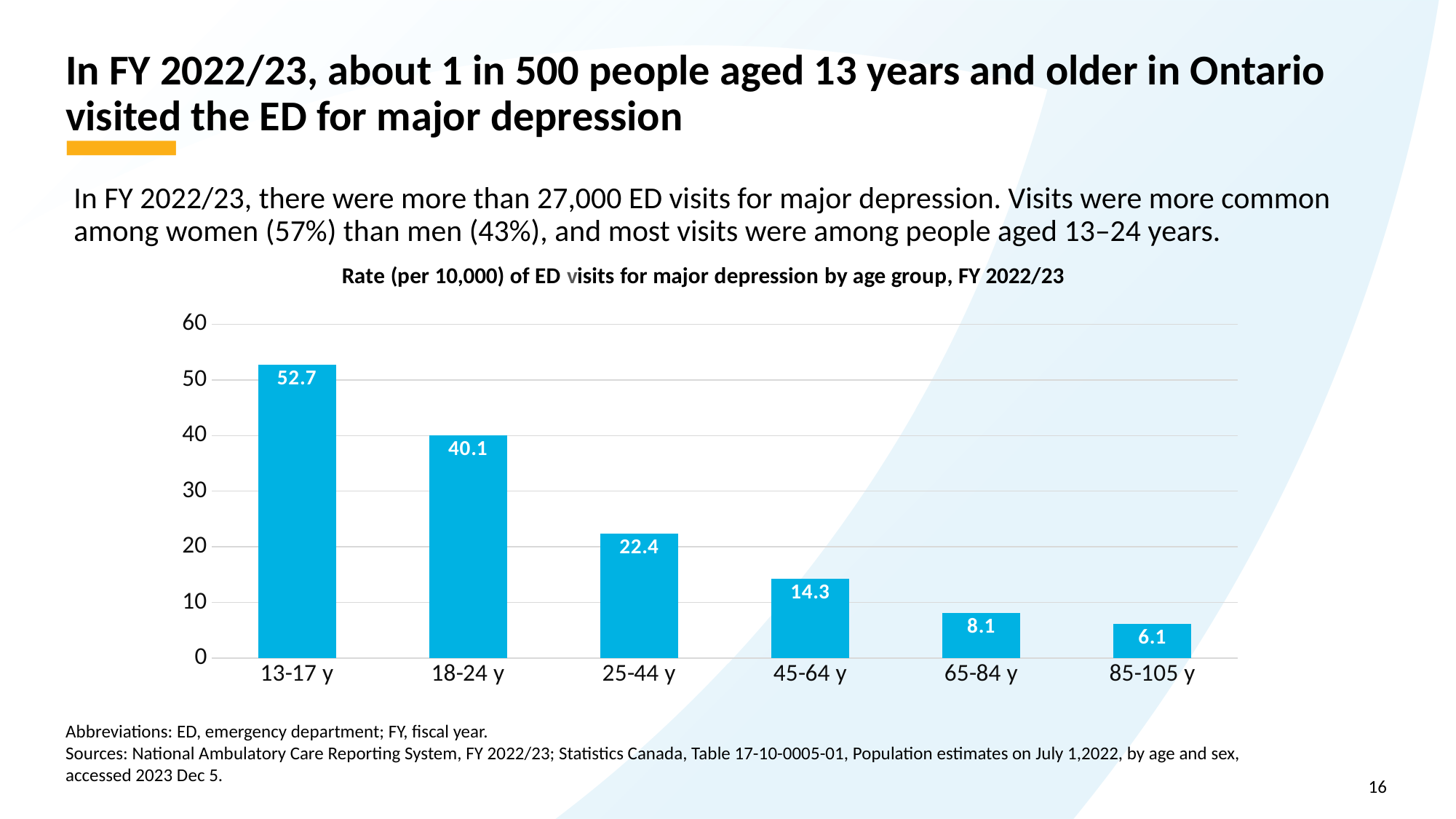
What is the rate (per 10,000) of ED visits for major depression for the 85-105 y age group? 6.1 Which age group has the highest rate of ED visits for major depression? 13-17 y Which age group has a higher rate of ED visits for major depression, 18-24 y or 25-44 y? 18-24 y What is the difference between the rates for the 13-17 y and 18-24 y age groups? 12.6 Which age group has the lowest rate of ED visits for major depression? 85-105 y How many age groups are shown in the chart? 6 What is the rate (per 10,000) of ED visits for major depression for the 45-64 y age group? 14.3 What kind of chart is used to show the rate of ED visits for major depression by age group? Bar chart Do the rates rise or fall as age group increases along the x axis? Fall Is the value for the 65-84 y age group greater or less than 10? less What is the rate (per 10,000) of ED visits for major depression for the 13-17 y age group? 52.7 What is the difference between the rates for the 25-44 y and 65-84 y age groups? 14.3